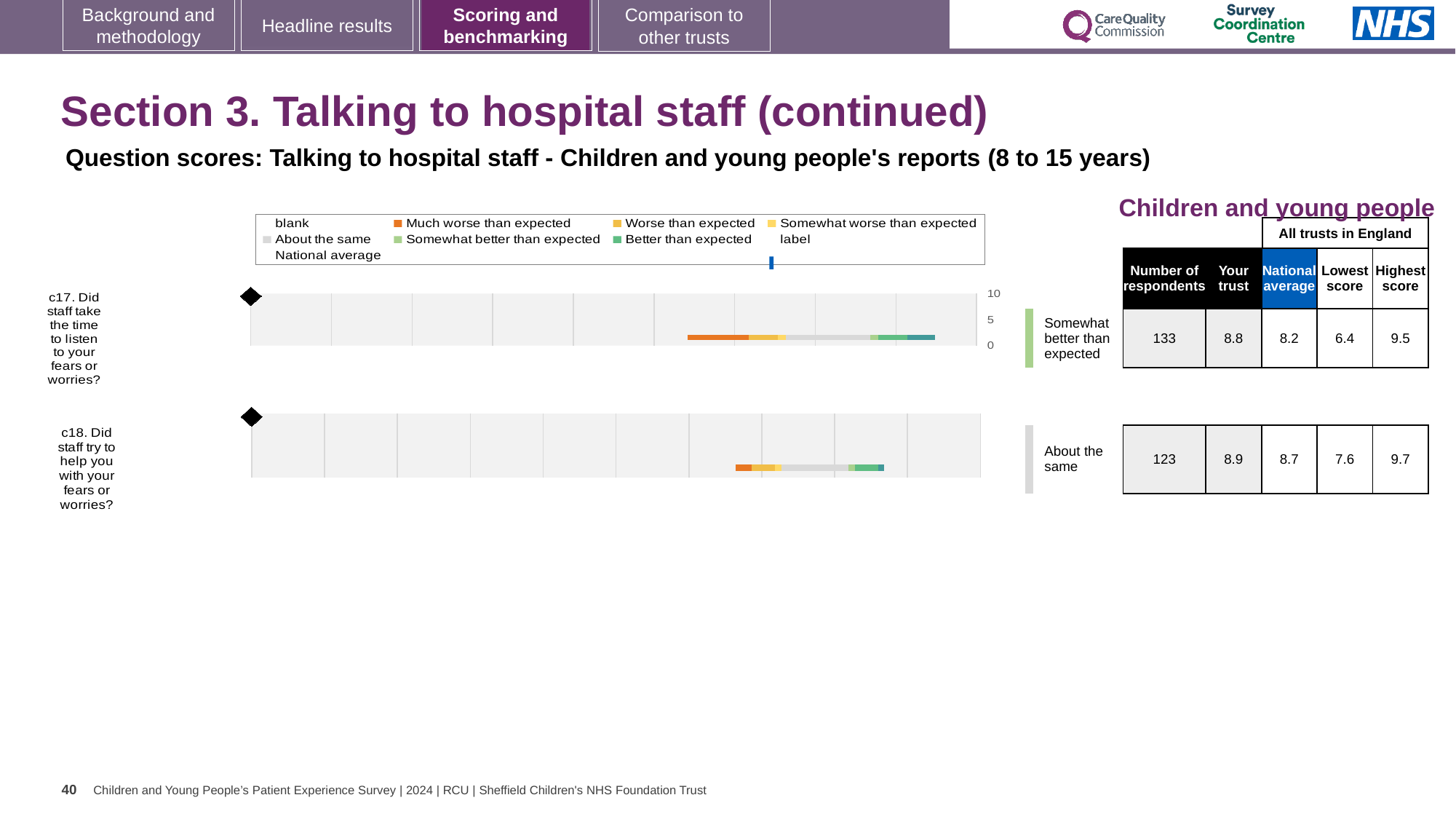
What is the highest score across all trusts in England for question c17? 9.5 What type of chart is used to show the question scores? Bar chart How many respondents answered question c17? 133 By how much does the trust's score for c17 exceed the national average for c17? 0.6 How many survey questions are plotted on this slide? 2 What is the difference between the highest and lowest trust scores for question c18? 2.1 Which benchmark category is the trust's result for question c17 placed in? Somewhat better than expected What is the lowest score across all trusts in England for question c18? 7.6 Which of the two questions has the higher national average score? c18 What is the 'Your trust' score for question c17 (Did staff take the time to listen to your fears or worries?)? 8.8 Which question has the higher 'Your trust' score, c17 or c18? c18 What is the national average score for question c18 (Did staff try to help you with your fears or worries?)? 8.7